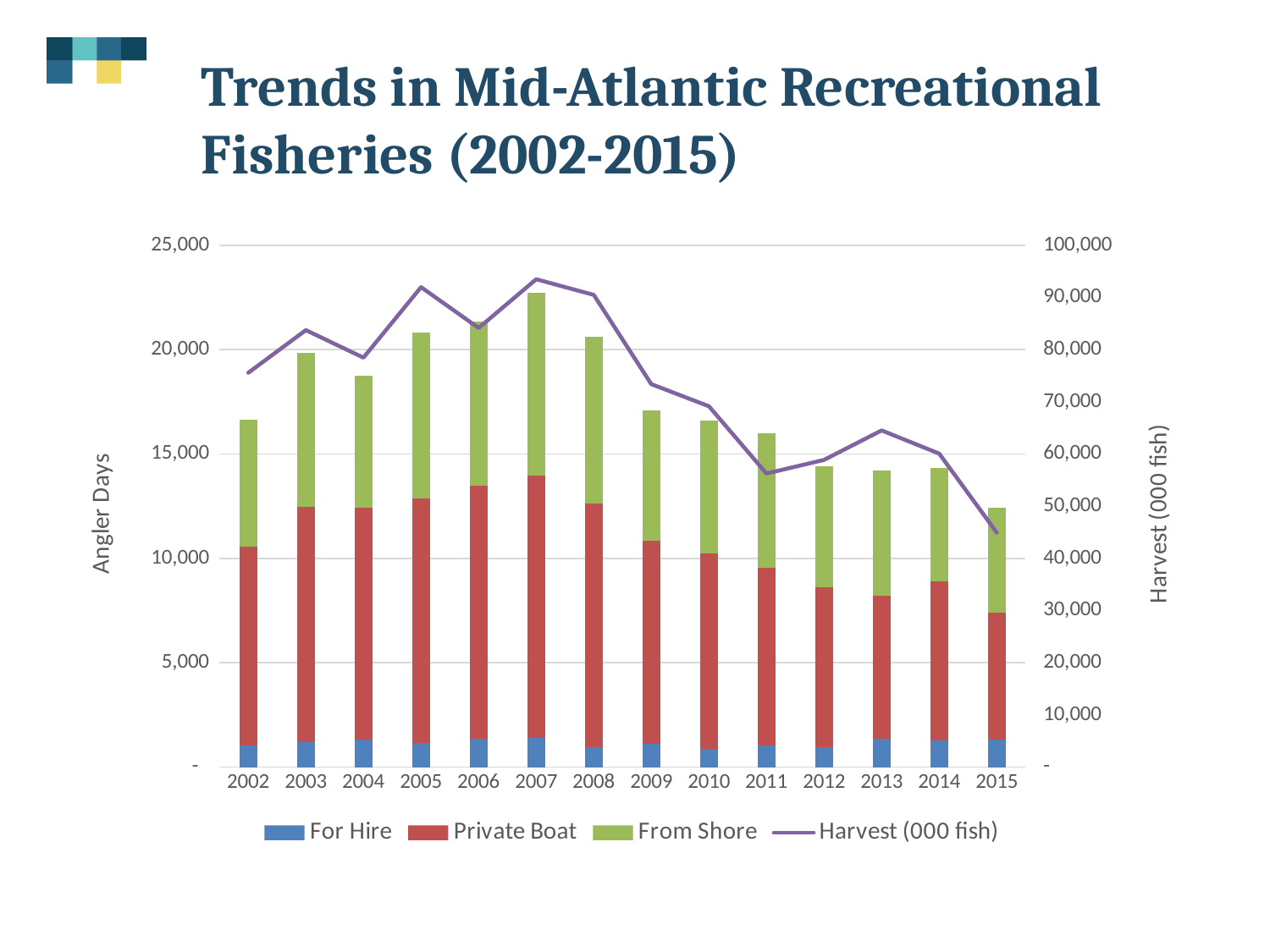
Which year has the tallest stacked bar for angler days? 2007 Which year has a taller total angler days bar, 2003 or 2012? 2003 What is the label of the right-hand vertical axis? Harvest (000 fish) Does the Harvest (000 fish) line rise or fall from 2008 to 2011? fall What kind of chart is used for the angler days data? Stacked bar chart Is the Harvest (000 fish) value for 2015 greater or less than 50,000? less How many years are shown on the x axis of the chart? 14 Which year has the lowest value on the Harvest (000 fish) line? 2015 Is the total angler days bar for 2007 greater or less than 20,000? greater How many series does the chart legend list? 4 Is the total angler days bar for 2015 greater or less than 15,000? less Which year has the shortest stacked bar for angler days? 2015